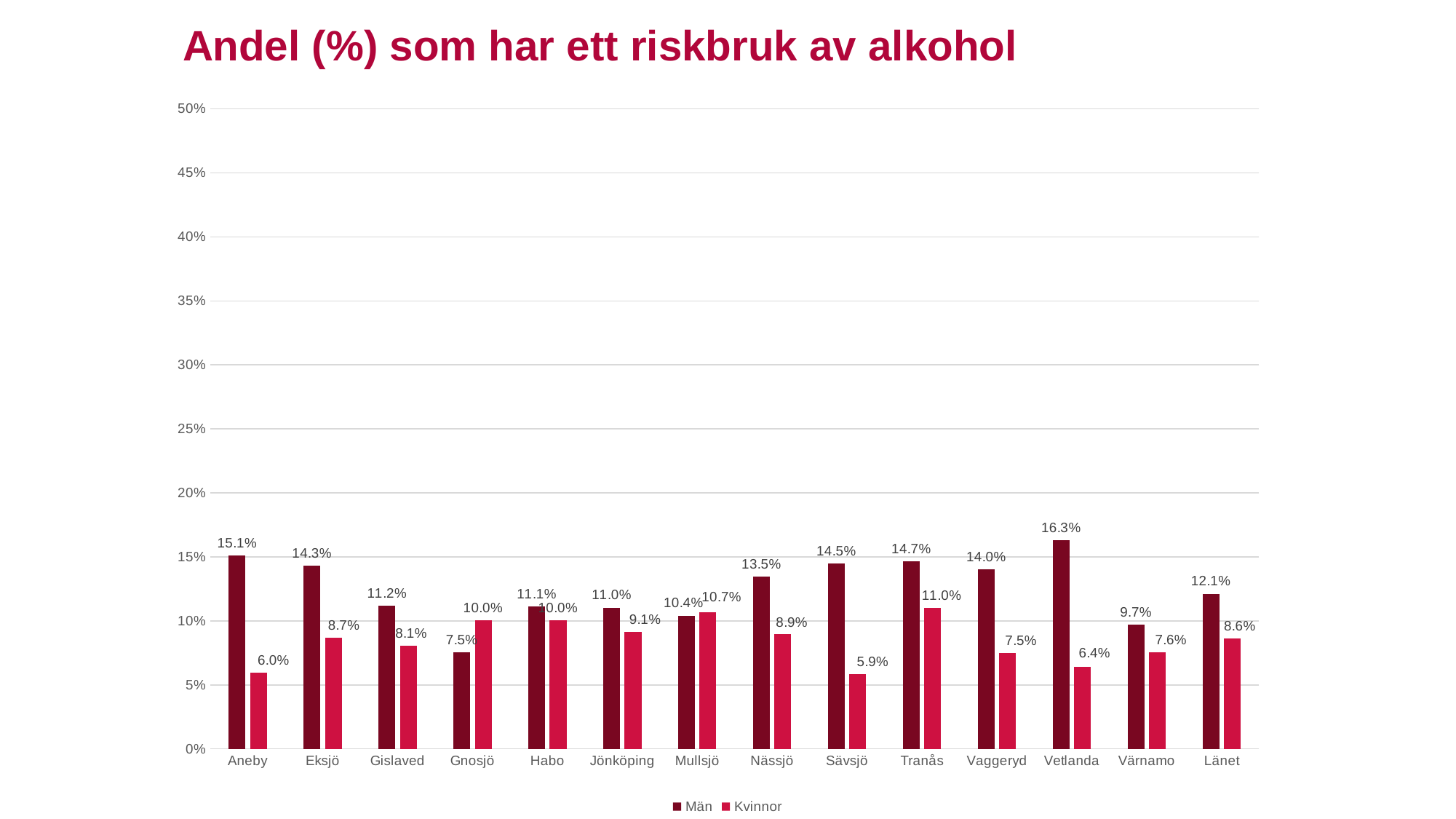
What type of chart is shown on the slide? bar chart Which is larger in Gnosjö, the value for Män or for Kvinnor? Kvinnor What is the difference between the Män and Kvinnor values in Aneby? 9.1 percentage points How many categories are shown on the x axis? 14 What is the value for Män in Vetlanda? 16.3% Which category has the highest value for Kvinnor? Tranås Which municipality has the lowest value for Män? Gnosjö How many series does the legend list? 2 What is the value for Kvinnor in Tranås? 11.0% Which municipality has the highest value for Män? Vetlanda What is the value for Kvinnor in Länet? 8.6% What is the title of the chart? Andel (%) som har ett riskbruk av alkohol